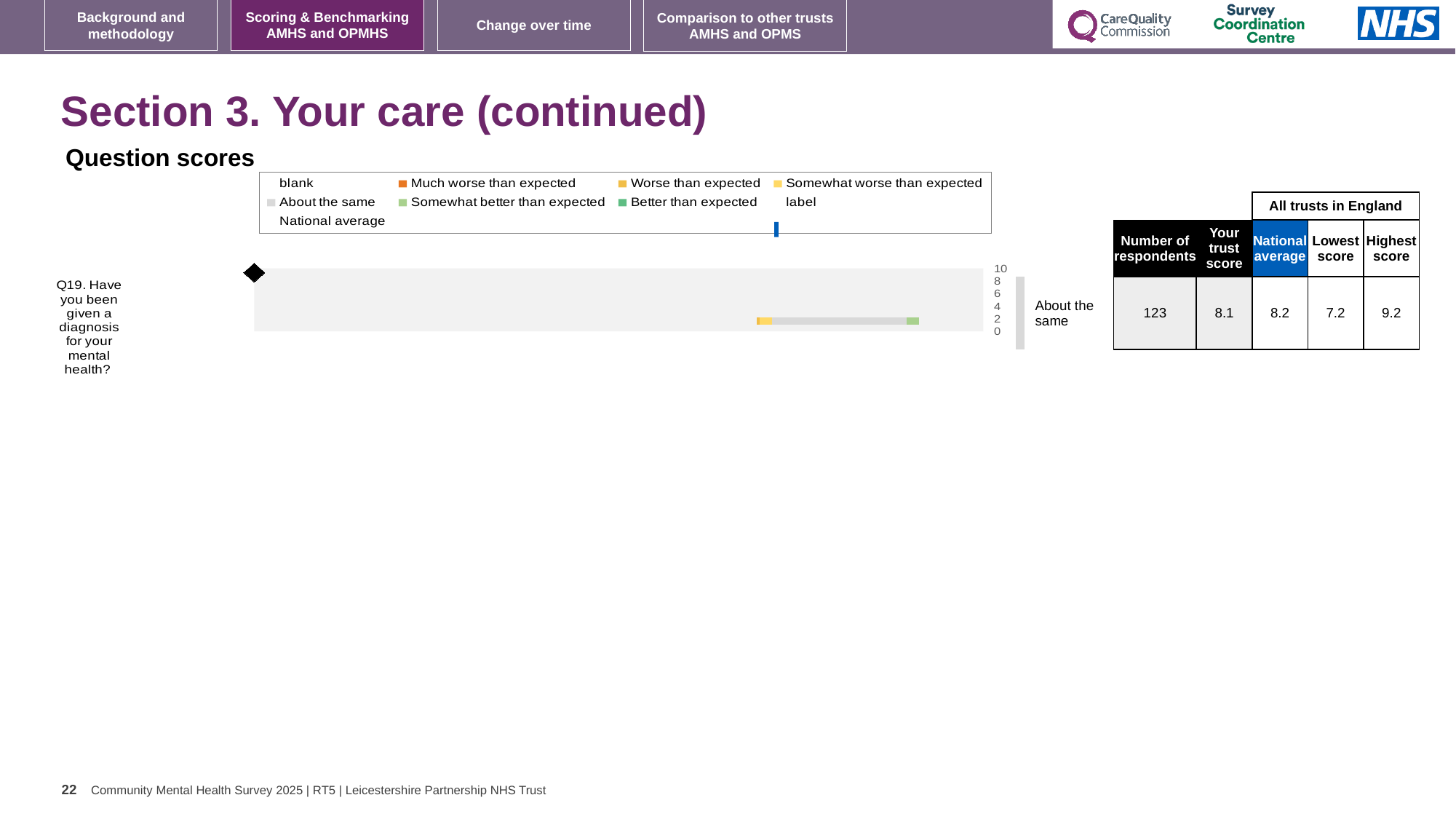
What is the lowest score among all trusts in England for Q19? 7.2 What benchmark label is shown to the right of the Q19 bar? About the same Which is larger for Q19: the trust's score or the national average? national average What kind of chart is used to show the Q19 question score? bar chart What is the trust's score for Q19? 8.1 What is the difference between the national average and the trust's score for Q19? 0.1 How many survey questions are plotted on the chart? 1 What is the highest score among all trusts in England for Q19? 9.2 Which question is plotted on the chart? Q19. Have you been given a diagnosis for your mental health? What is the difference between the highest score and the lowest score for Q19? 2.0 How many respondents answered Q19? 123 What is the national average score for Q19? 8.2